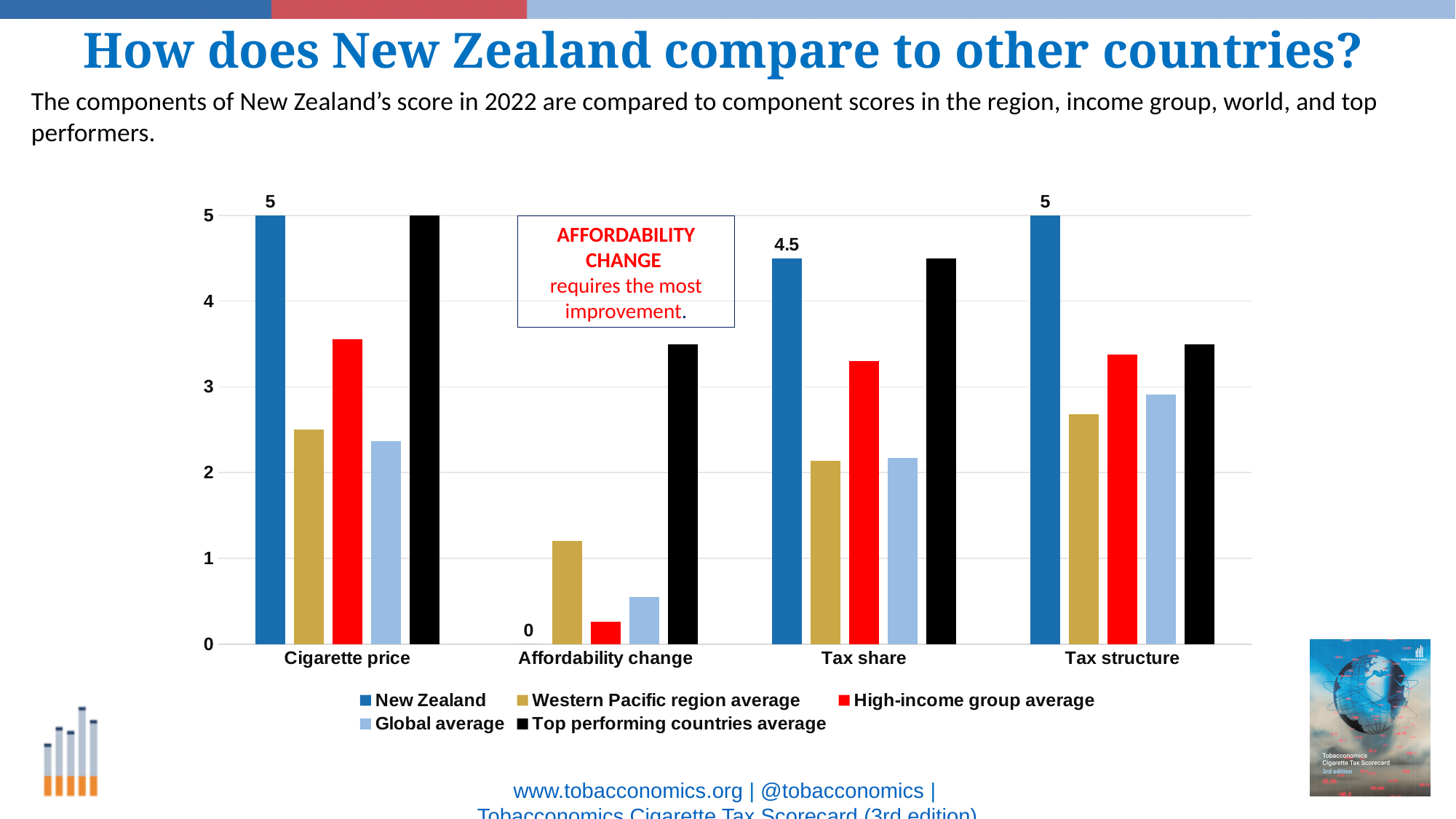
What is New Zealand's score for Affordability change? 0 How many components are shown on the x axis? 4 What is New Zealand's score for Cigarette price? 5 Is the High-income group average for Affordability change greater or less than 1? less What is New Zealand's score for Tax structure? 5 What is the difference between New Zealand's Cigarette price score and its Tax share score? 0.5 Which component has the lowest New Zealand score? Affordability change Is the Western Pacific region average for Cigarette price greater or less than 2? greater How many series does the legend list? 5 For Tax share, which is larger: the High-income group average or the Global average? High-income group average What type of chart is shown on the slide? Bar chart What is New Zealand's score for Tax share? 4.5